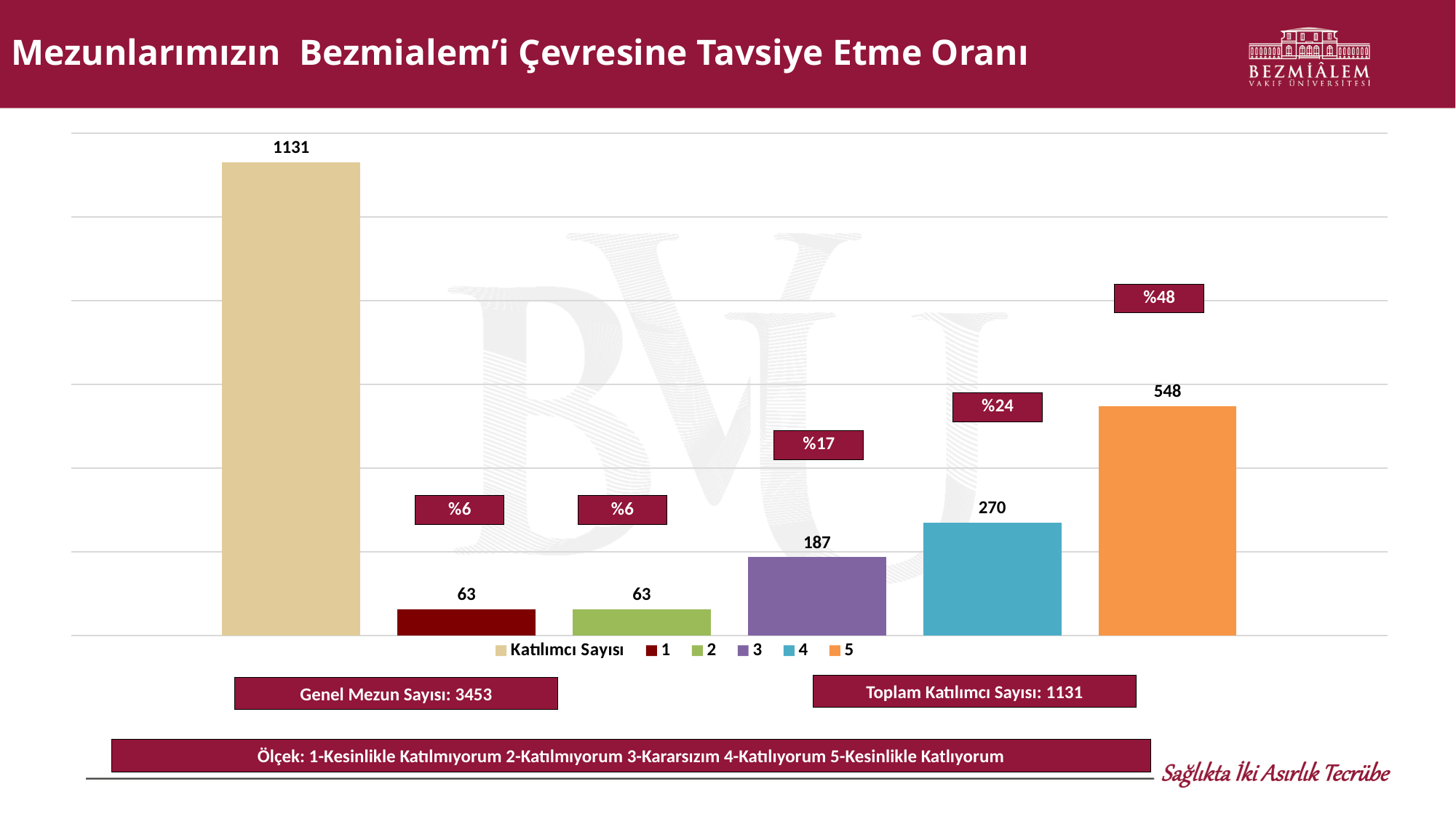
What is the difference between the values for category 3 and category 1? 124 What is the value of the bar for category 3? 187 How many series does the legend list? 6 What is the value of the bar for category 5? 548 What percentage label is shown above the bar for category 5? %48 Which is larger, the value for category 4 or the value for category 3? category 4 What is the title of the slide containing the chart? Mezunlarımızın Bezmialem'i Çevresine Tavsiye Etme Oranı What kind of chart is shown on the slide? bar chart Which of the rating categories 1 to 5 has the highest bar? 5 What is the value of the Katılımcı Sayısı bar? 1131 What is the value of the bar for category 4? 270 What is the difference between the values for category 5 and category 4? 278